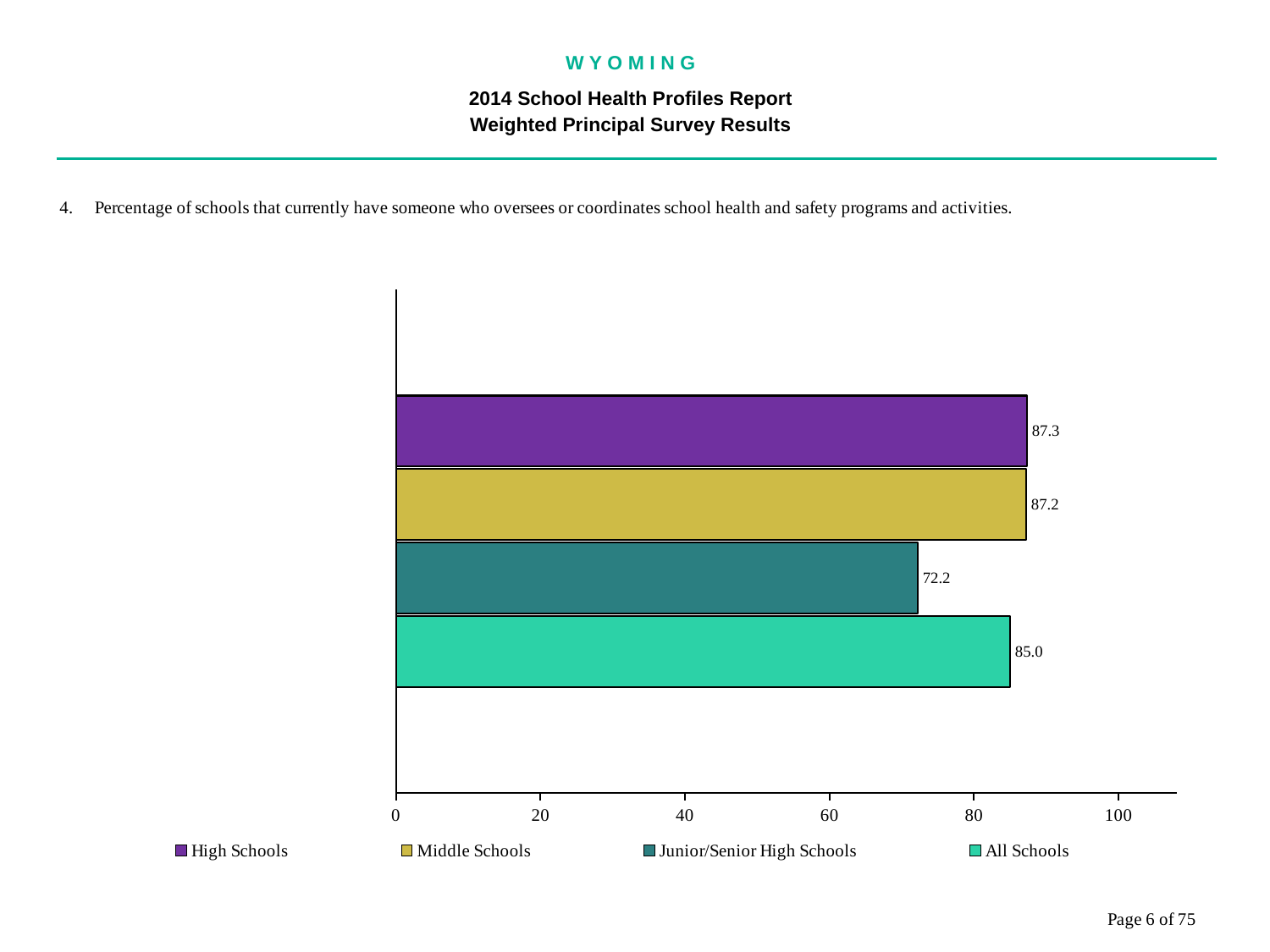
How many entries does the legend list? 4 What is the value for Junior/Senior High Schools? 72.2 Which school type has the lowest value? Junior/Senior High Schools What is the value for All Schools? 85.0 How many bars are shown in the chart? 4 What is the difference between the values for All Schools and Junior/Senior High Schools? 12.8 What kind of chart is shown on the slide? bar chart What is the difference between the values for High Schools and Junior/Senior High Schools? 15.1 What is the value for High Schools? 87.3 Which is larger, the value for All Schools or the value for Junior/Senior High Schools? All Schools Is the value for Junior/Senior High Schools greater or less than 80? less What is the value for Middle Schools? 87.2